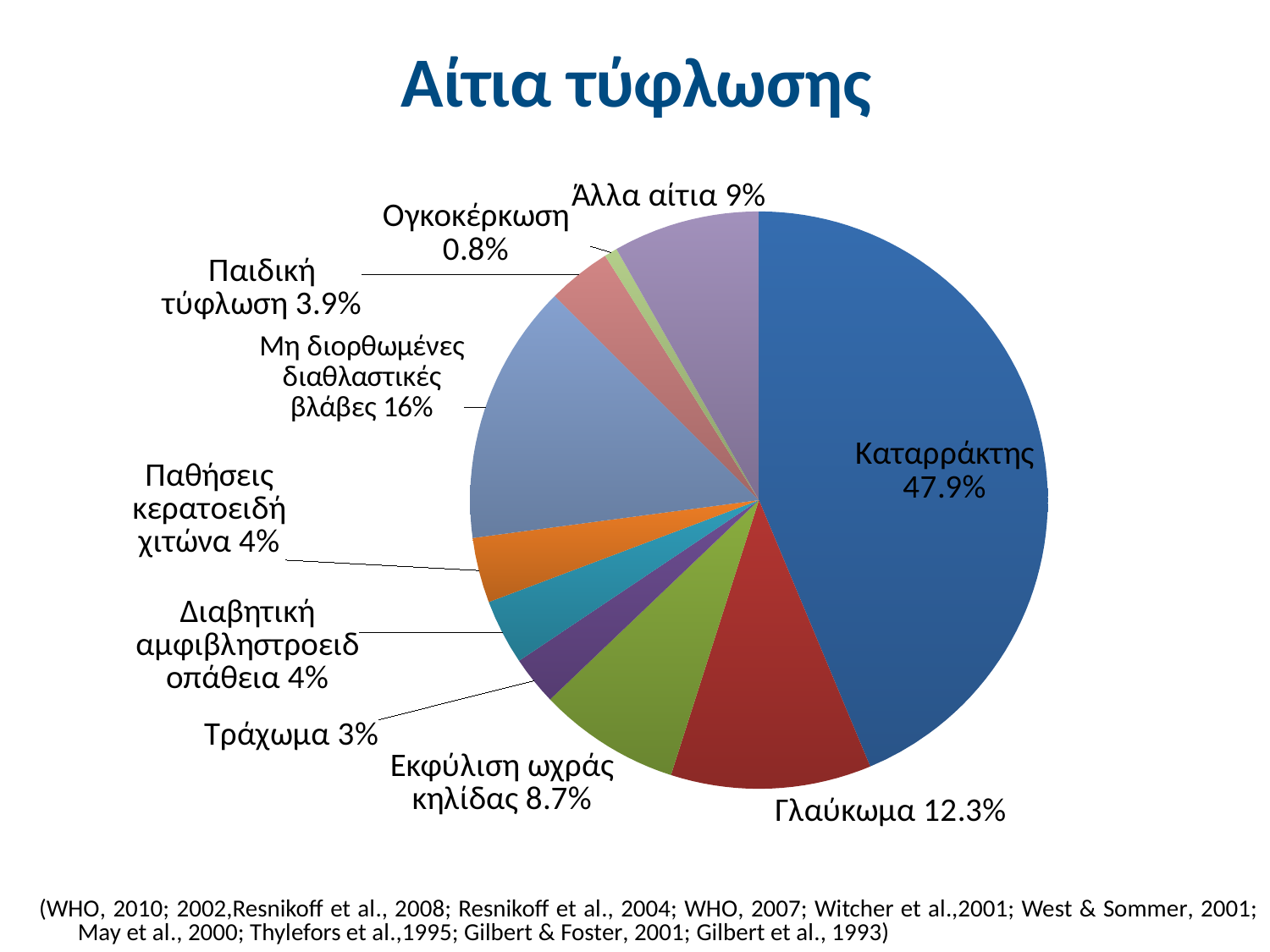
What percentage is shown for Μη διορθωμένες διαθλαστικές βλάβες (uncorrected refractive errors)? 16% What share does Γλαύκωμα (glaucoma) have in the pie chart? 12.3% Which is larger: the slice for Εκφύλιση ωχράς κηλίδας or the slice for Άλλα αίτια? Άλλα αίτια What type of chart is shown on the slide? pie chart What value is labelled for Ογκοκέρκωση (onchocerciasis)? 0.8% What percentage is labelled for Παιδική τύφλωση (childhood blindness)? 3.9% Which cause has the smallest slice of the pie? Ογκοκέρκωση What is the difference in percentage points between Καταρράκτης (47.9%) and Γλαύκωμα (12.3%)? 35.6 Which cause has the largest slice of the pie? Καταρράκτης What percentage of the pie is attributed to Καταρράκτης (cataract)? 47.9% What is the title of the chart? Αίτια τύφλωσης How many slices (causes) does the pie chart contain? 10